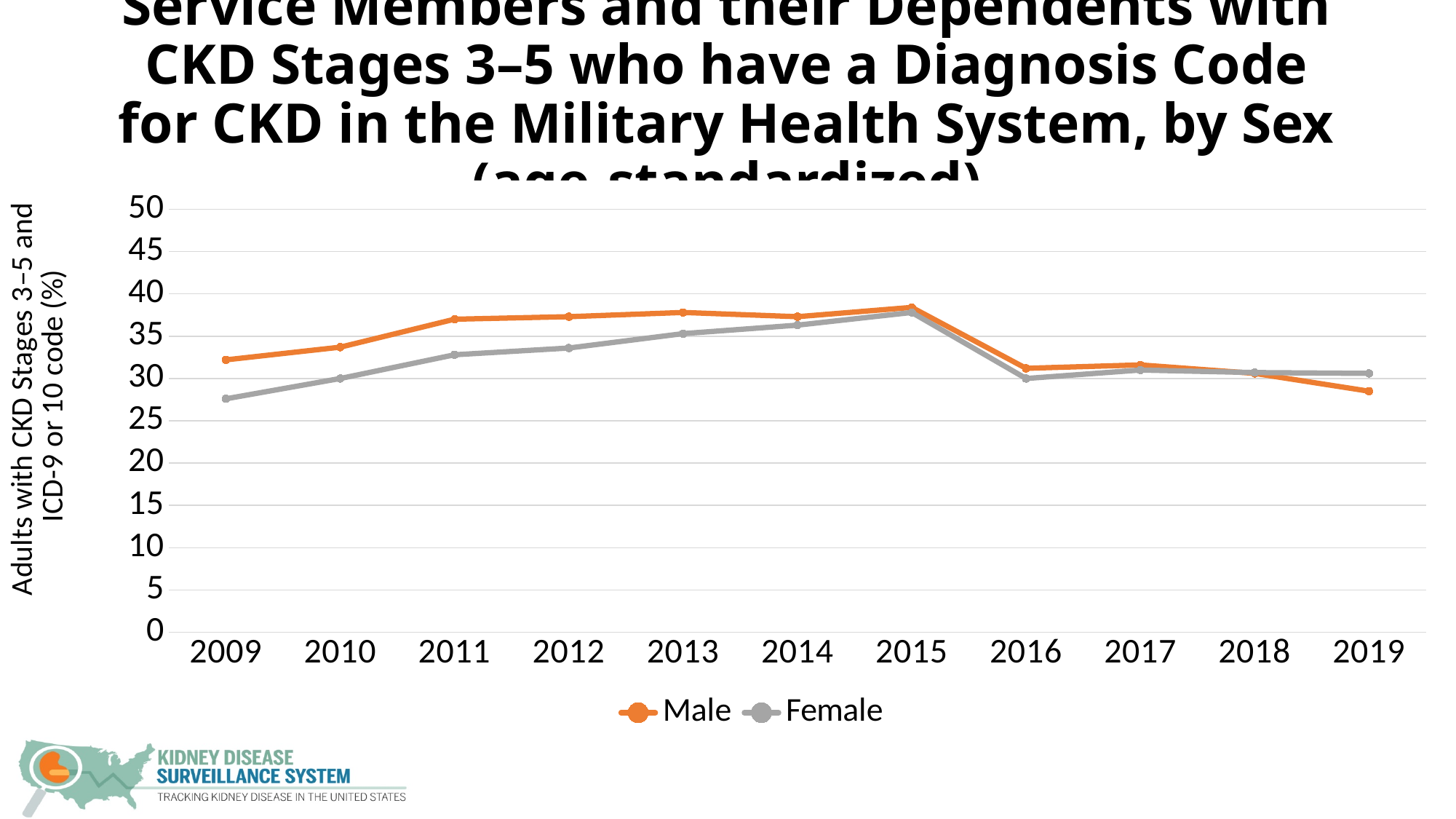
In which year is the Female series at its highest? 2015 How many series does the legend list? 2 What kind of chart is shown on the slide? line chart Is the value for Male in 2015 greater or less than 40? less In 2009, which series has the larger value, Male or Female? Male How many years are plotted along the x axis? 11 In which year is the Female series at its lowest? 2009 In 2019, which series has the larger value, Male or Female? Female Is the value for Male in 2009 greater or less than 30? greater Does the Female series rise or fall from 2009 to 2015? rise Is the value for Female in 2009 greater or less than 30? less In which year is the Male series at its lowest? 2019